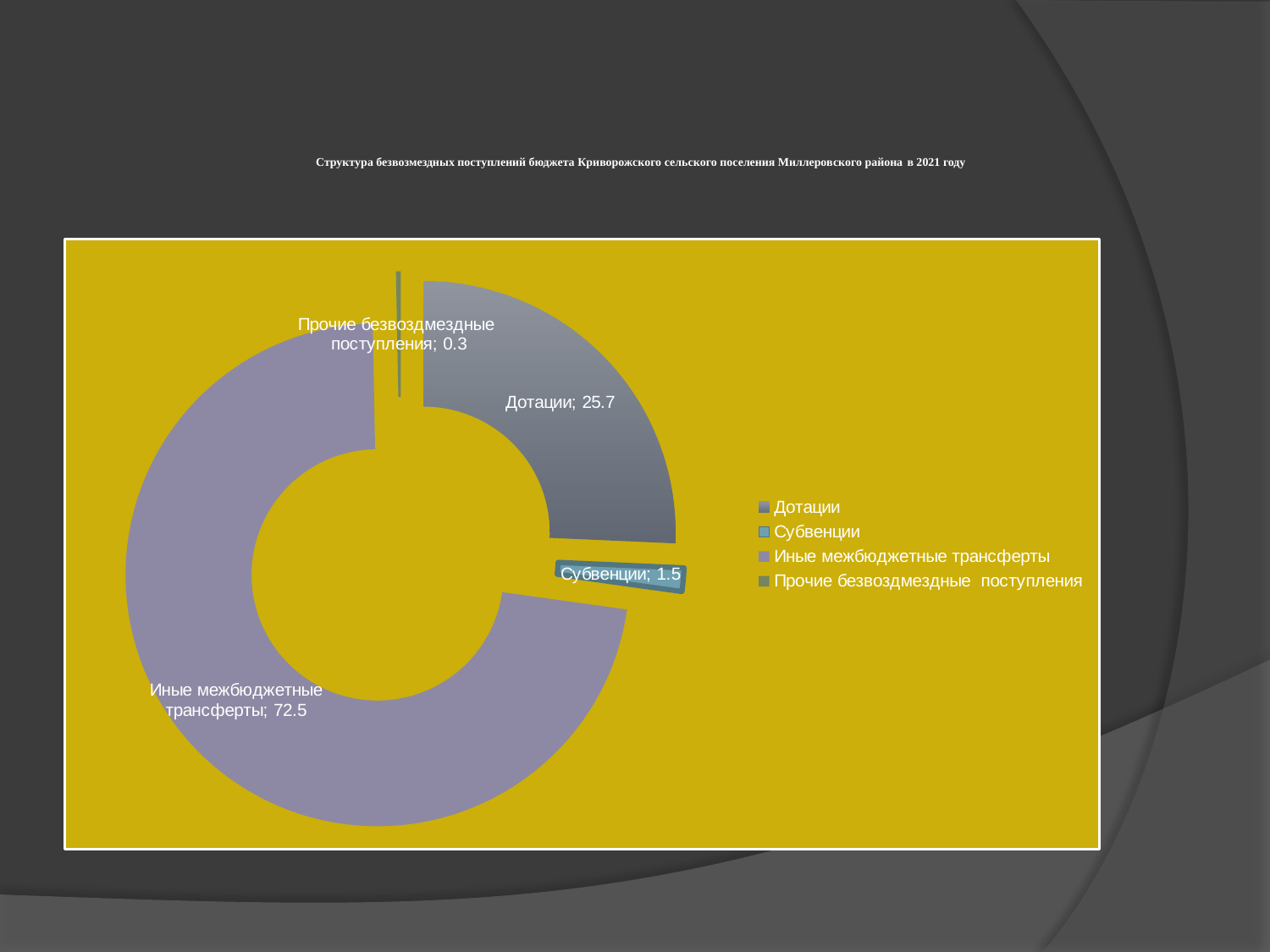
Which is larger, the value for Субвенции or the value for Прочие безвозмездные поступления? Субвенции Which category has the smallest value? Прочие безвозмездные поступления What is the difference between the values for Иные межбюджетные трансферты and Дотации? 46.8 What is the difference between the values for Дотации and Субвенции? 24.2 What kind of chart is shown on the slide? Doughnut chart What is the value shown for Субвенции? 1.5 What is the value shown for Прочие безвозмездные поступления? 0.3 How many categories does the chart show? 4 What is the value shown for Иные межбюджетные трансферты? 72.5 What share of the total does Дотации represent? 25.7% Which category has the largest value? Иные межбюджетные трансферты What is the value shown for Дотации? 25.7